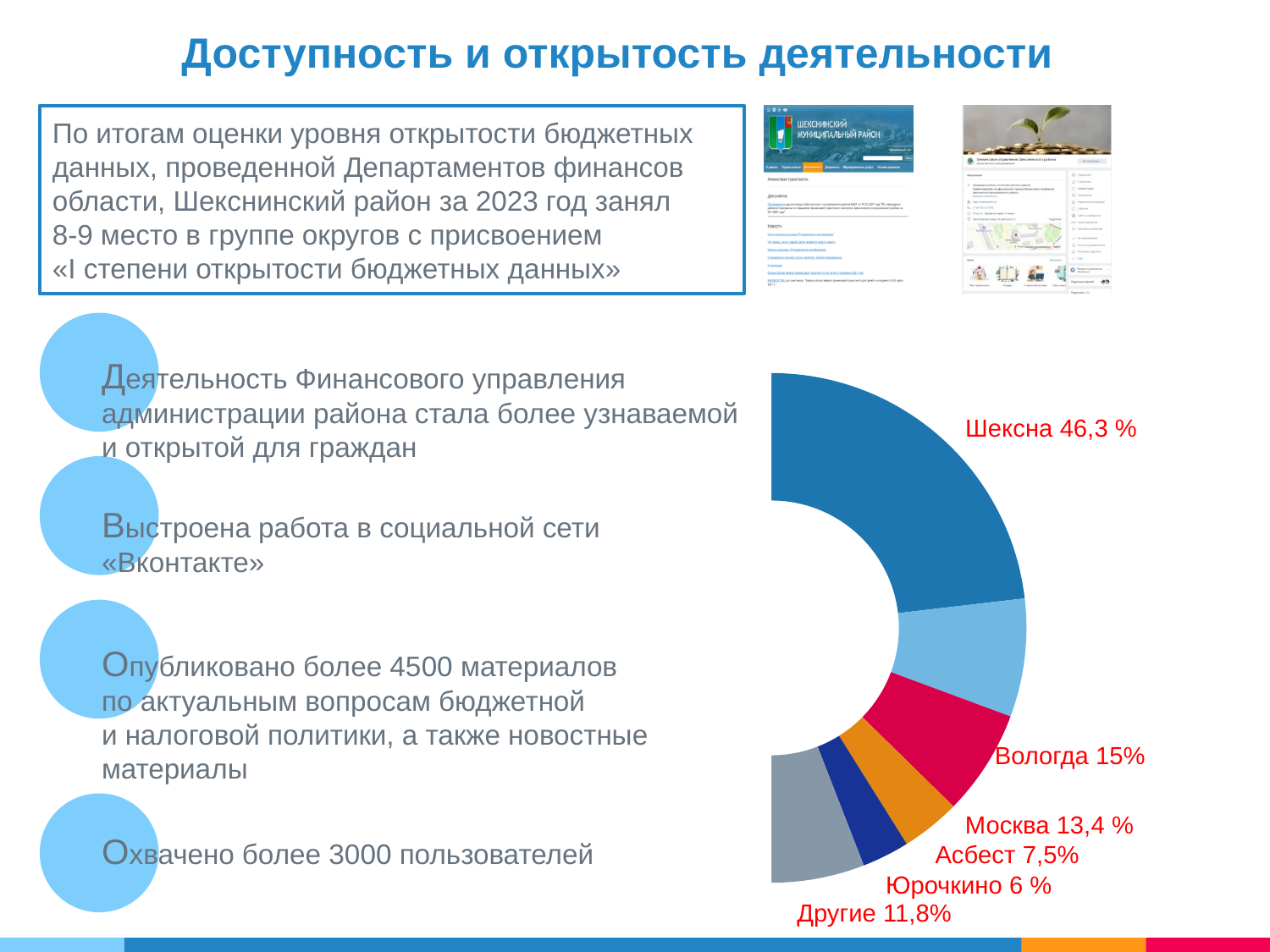
What value is shown for Другие in the chart? 11,8% Which category has the smallest share in the chart? Юрочкино What value is shown for Вологда in the chart? 15% What value is shown for Москва in the chart? 13,4 % Which is larger, the share of Вологда or the share of Москва? Вологда What value is shown for Асбест in the chart? 7,5% Which category has the largest share in the chart? Шексна What kind of chart is shown on the slide? doughnut chart What share does Шексна have in the doughnut chart? 46,3 % What is the difference between the shares of Москва and Асбест? 5,9 % How many categories are labelled in the chart? 6 What is the difference between the shares of Шексна and Вологда? 31,3 %